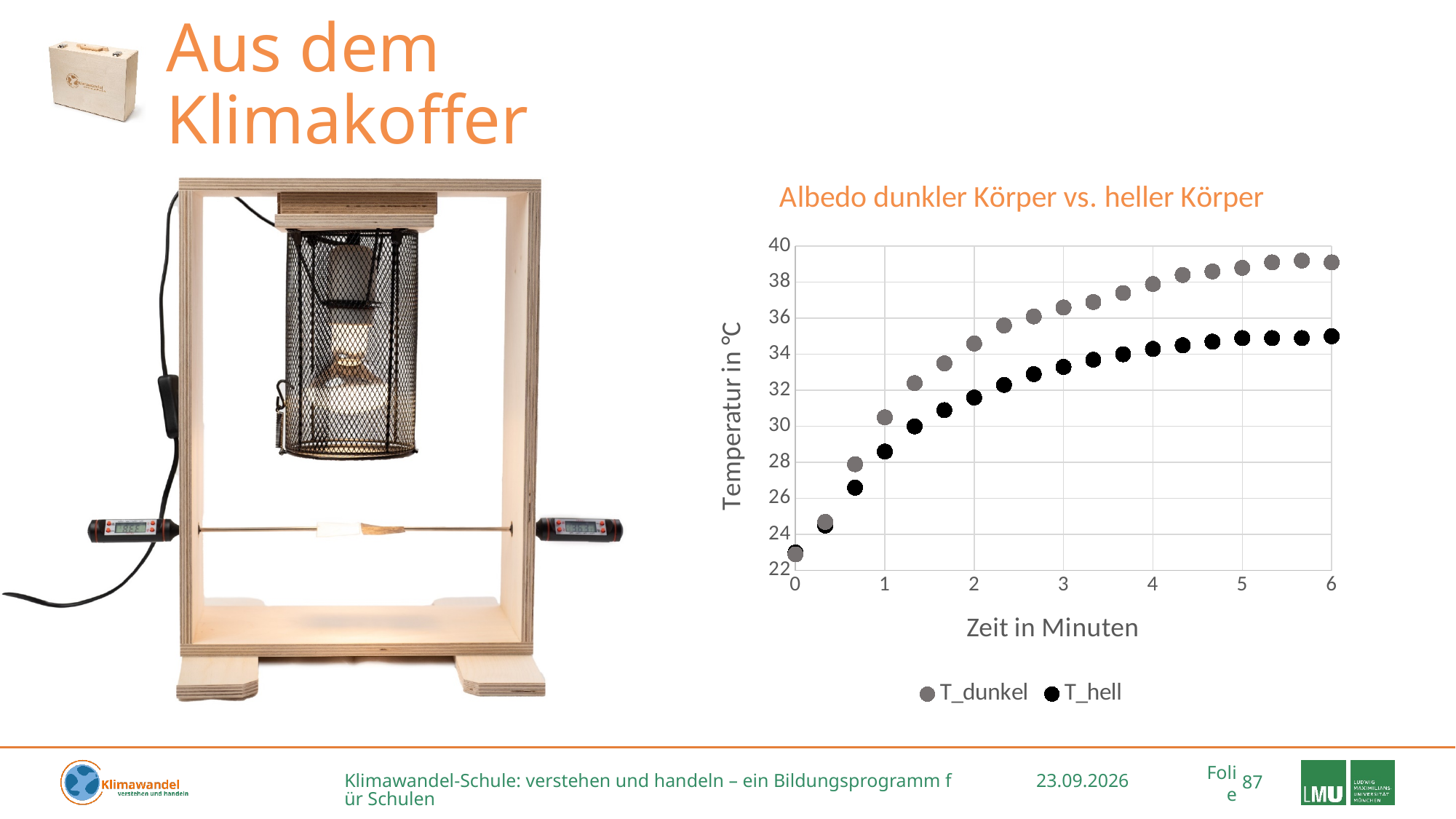
Is the value for T_hell at 1 minute greater or less than 30? less Is the value for T_dunkel at 3 minutes greater or less than 36? greater What kind of chart is shown on the slide? scatter chart Which series has the higher temperature at 4 minutes, T_dunkel or T_hell? T_dunkel What is the title of the chart? Albedo dunkler Körper vs. heller Körper Is the value for T_hell at 3 minutes greater or less than 34? less How many series does the chart's legend list? 2 Which series has the higher temperature at 6 minutes, T_dunkel or T_hell? T_dunkel Do the T_dunkel values rise or fall as time increases along the x axis? rise What are the two series named in the chart's legend? T_dunkel and T_hell